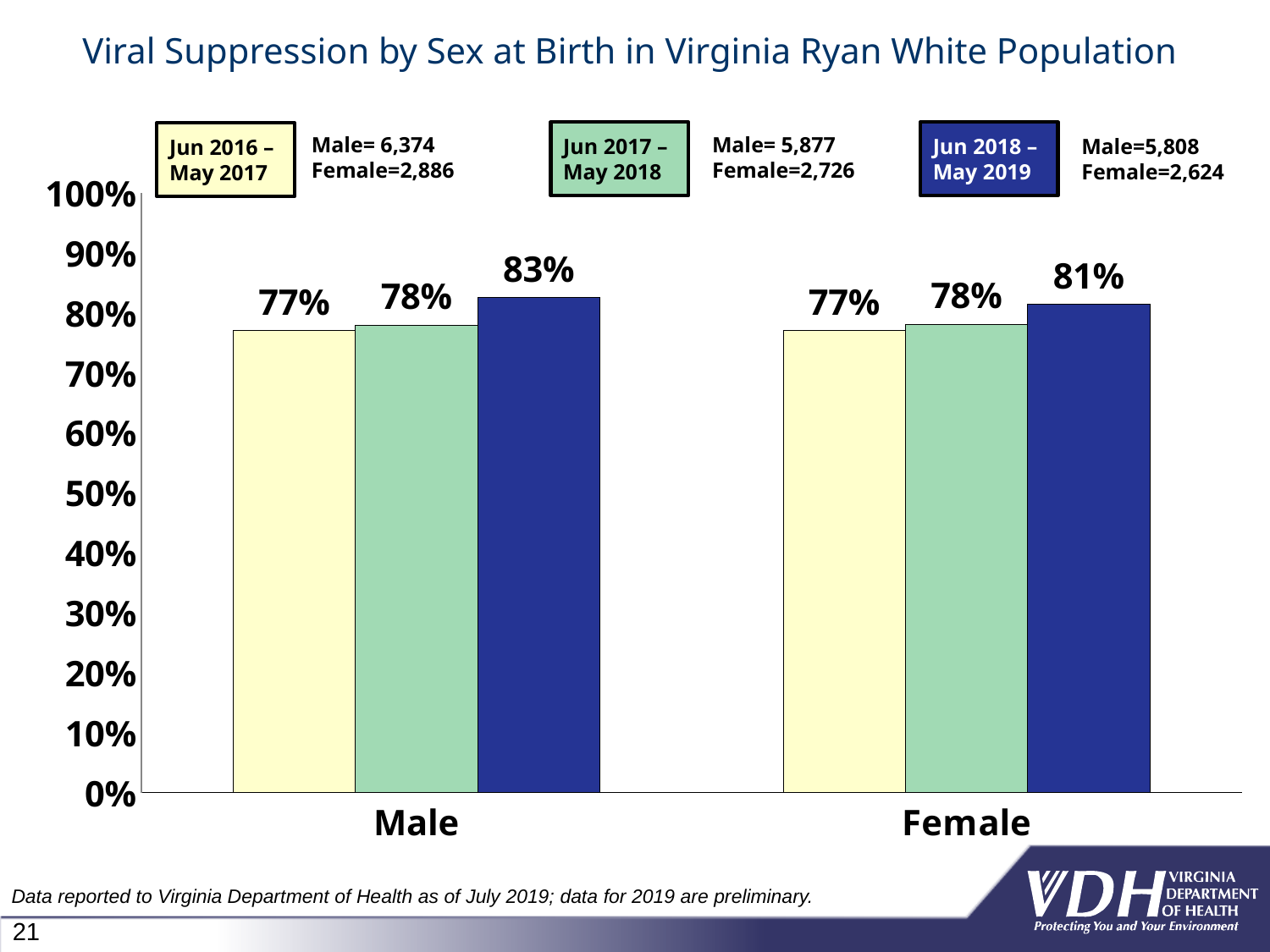
What is the difference between the Male and Female viral suppression percentages in Jun 2018 – May 2019? 2% What kind of chart is shown on the slide? Bar chart How many sex-at-birth categories are shown on the x axis? 2 By how many percentage points did Male viral suppression increase from Jun 2016 – May 2017 to Jun 2018 – May 2019? 6% Do the viral suppression percentages for Female rise or fall across the three periods? Rise What is the viral suppression percentage for Female in Jun 2018 – May 2019? 81% Which is larger in Jun 2018 – May 2019, the Male or the Female viral suppression percentage? Male What is the viral suppression percentage for Female in Jun 2016 – May 2017? 77% How many time periods (series) does the legend list? 3 Which period has the highest viral suppression percentage for Male? Jun 2018 – May 2019 What is the viral suppression percentage for Male in Jun 2017 – May 2018? 78% What is the viral suppression percentage for Male in Jun 2018 – May 2019? 83%